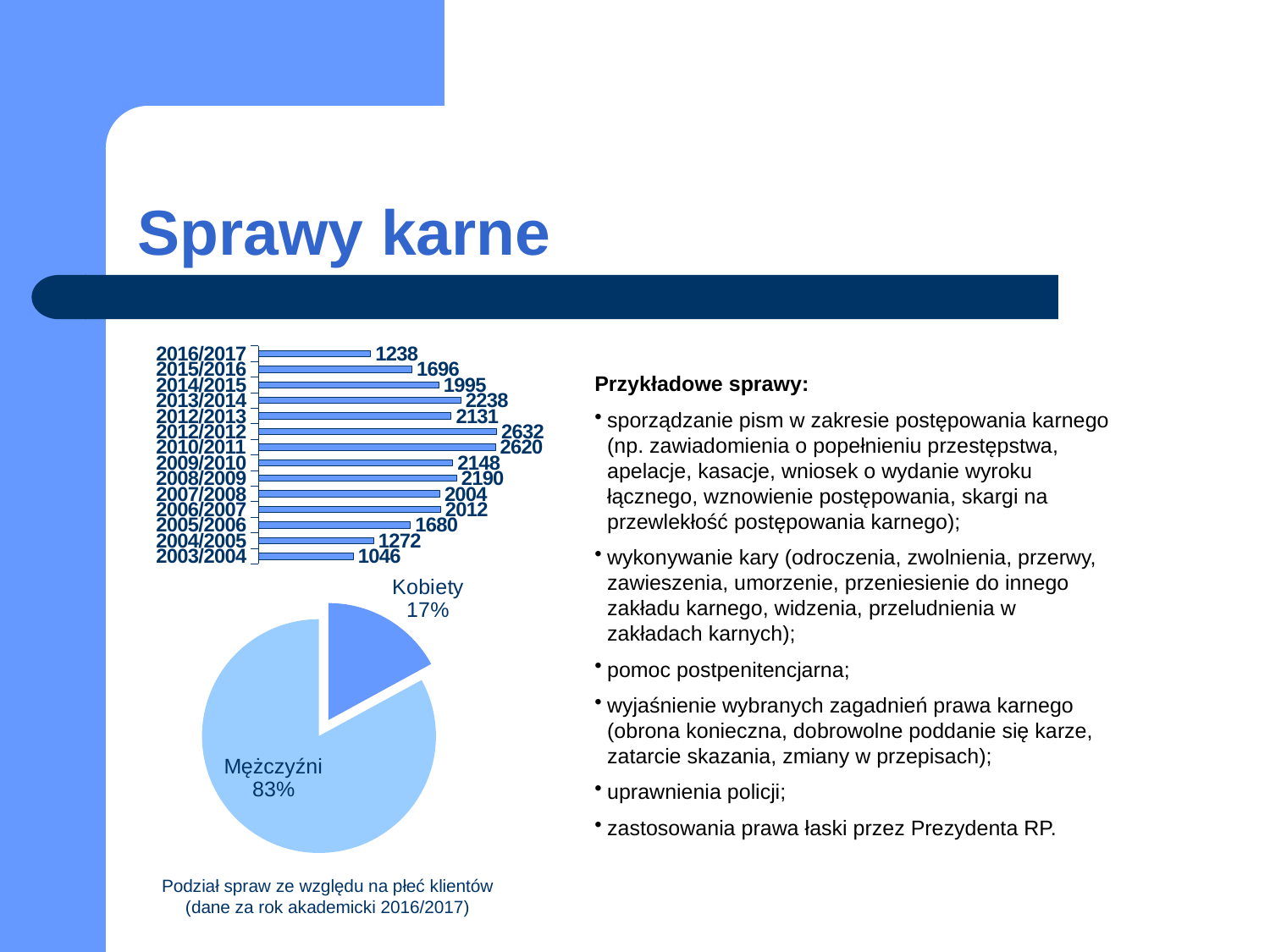
In the bar chart at the top left, what is the value for 2003/2004? 1046 What type of chart is the chart at the top left of the slide? Bar chart How many academic years are shown in the bar chart at the top left? 14 In the bar chart at the top left, what is the value for 2016/2017? 1238 In the bar chart at the top left, which is larger, the value for 2008/2009 or the value for 2009/2010? 2008/2009 In the pie chart titled 'Podział spraw ze względu na płeć klientów', what share is Mężczyźni? 83% In the bar chart at the top left, what is the value for 2013/2014? 2238 What type of chart is the chart titled 'Podział spraw ze względu na płeć klientów'? Pie chart In the bar chart at the top left, which academic year has the lowest value? 2003/2004 In the bar chart at the top left, what is the highest value shown? 2632 In the pie chart titled 'Podział spraw ze względu na płeć klientów', what share is Kobiety? 17% In the bar chart at the top left, what is the difference between the values for 2015/2016 and 2016/2017? 458